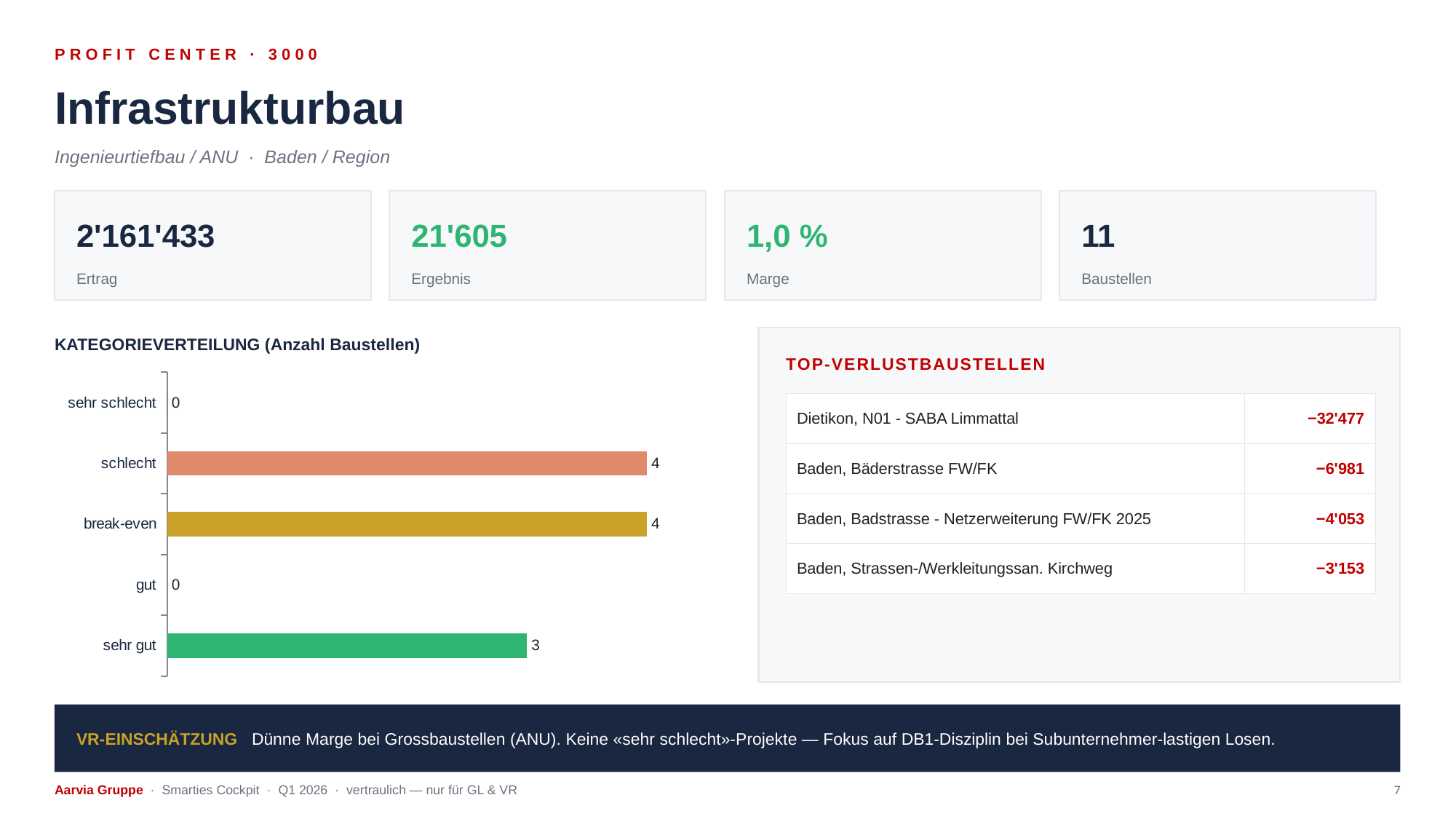
What colour is the bar for 'sehr gut' in the KATEGORIEVERTEILUNG chart? green What is the value for 'sehr gut' in the KATEGORIEVERTEILUNG chart? 3 Which category has the lowest non-zero value in the KATEGORIEVERTEILUNG chart? sehr gut What is the value for 'break-even' in the KATEGORIEVERTEILUNG chart? 4 What is the total of all values shown in the KATEGORIEVERTEILUNG chart? 11 What kind of chart is the KATEGORIEVERTEILUNG chart? bar chart How many categories are shown in the KATEGORIEVERTEILUNG chart? 5 Which is larger in the KATEGORIEVERTEILUNG chart: the value for 'break-even' or the value for 'sehr gut'? break-even What is the value for 'sehr schlecht' in the KATEGORIEVERTEILUNG chart? 0 How many categories in the KATEGORIEVERTEILUNG chart have a value of 0? 2 What is the value for 'schlecht' in the KATEGORIEVERTEILUNG chart? 4 What is the difference between the values for 'schlecht' and 'sehr gut' in the KATEGORIEVERTEILUNG chart? 1